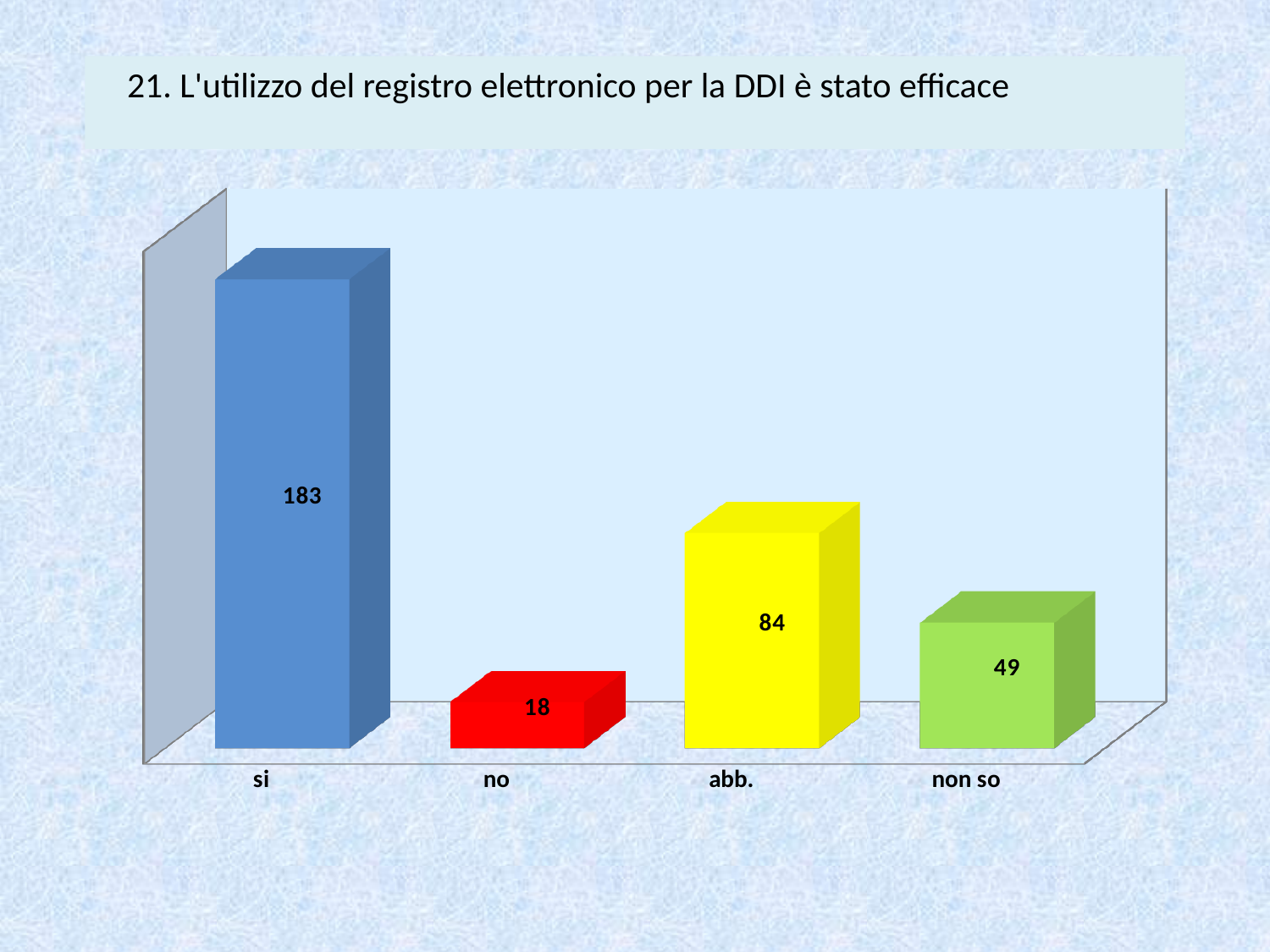
What is the value for "no"? 18 What is the value for "non so"? 49 Which category has the lowest value? no Which is larger, the value for "abb." or the value for "non so"? abb. What kind of chart is shown on the slide? bar chart What is the difference between the values for "si" and "abb."? 99 Which category has the highest value? si What colour is the bar for "abb."? yellow What is the difference between the values for "non so" and "no"? 31 How many categories are shown in the chart? 4 What is the value for "abb."? 84 What is the value for "si"? 183